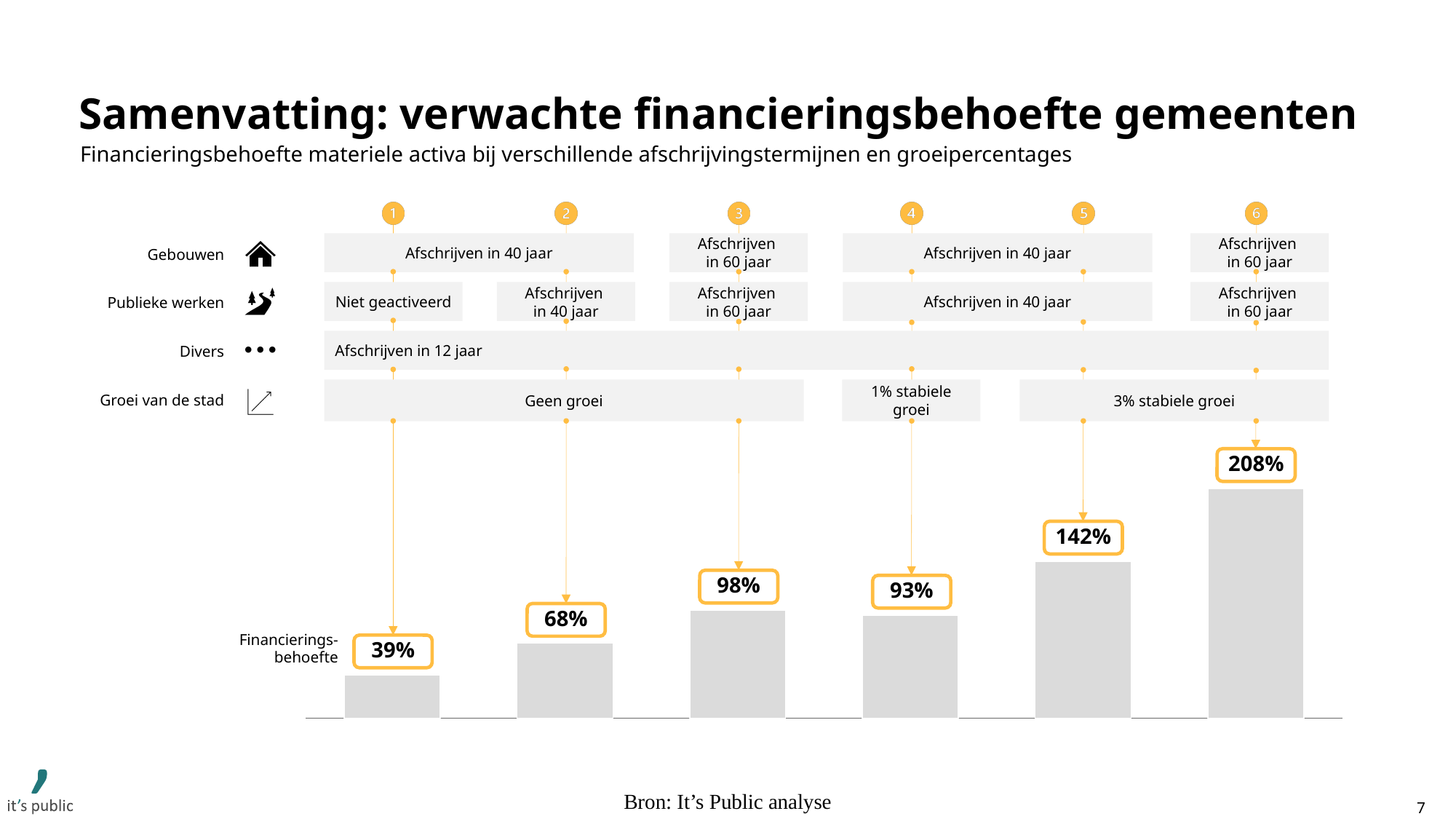
What is the financieringsbehoefte value for scenario 1? 39% What is the financieringsbehoefte value for scenario 4? 93% What is the difference between the financieringsbehoefte of scenario 2 and scenario 1? 29% What is the difference between the financieringsbehoefte of scenario 6 and scenario 5? 66% What is the financieringsbehoefte value for scenario 6? 208% What is the depreciation assumption for Divers across all scenarios? Afschrijven in 12 jaar Which has a larger financieringsbehoefte, scenario 3 or scenario 4? Scenario 3 Which scenario has the highest financieringsbehoefte? Scenario 6 How many scenarios (bars) are shown in the chart? 6 Which scenario has the lowest financieringsbehoefte? Scenario 1 What growth assumption (Groei van de stad) applies to scenarios 5 and 6? 3% stabiele groei What kind of chart is used to show the financieringsbehoefte? Bar chart